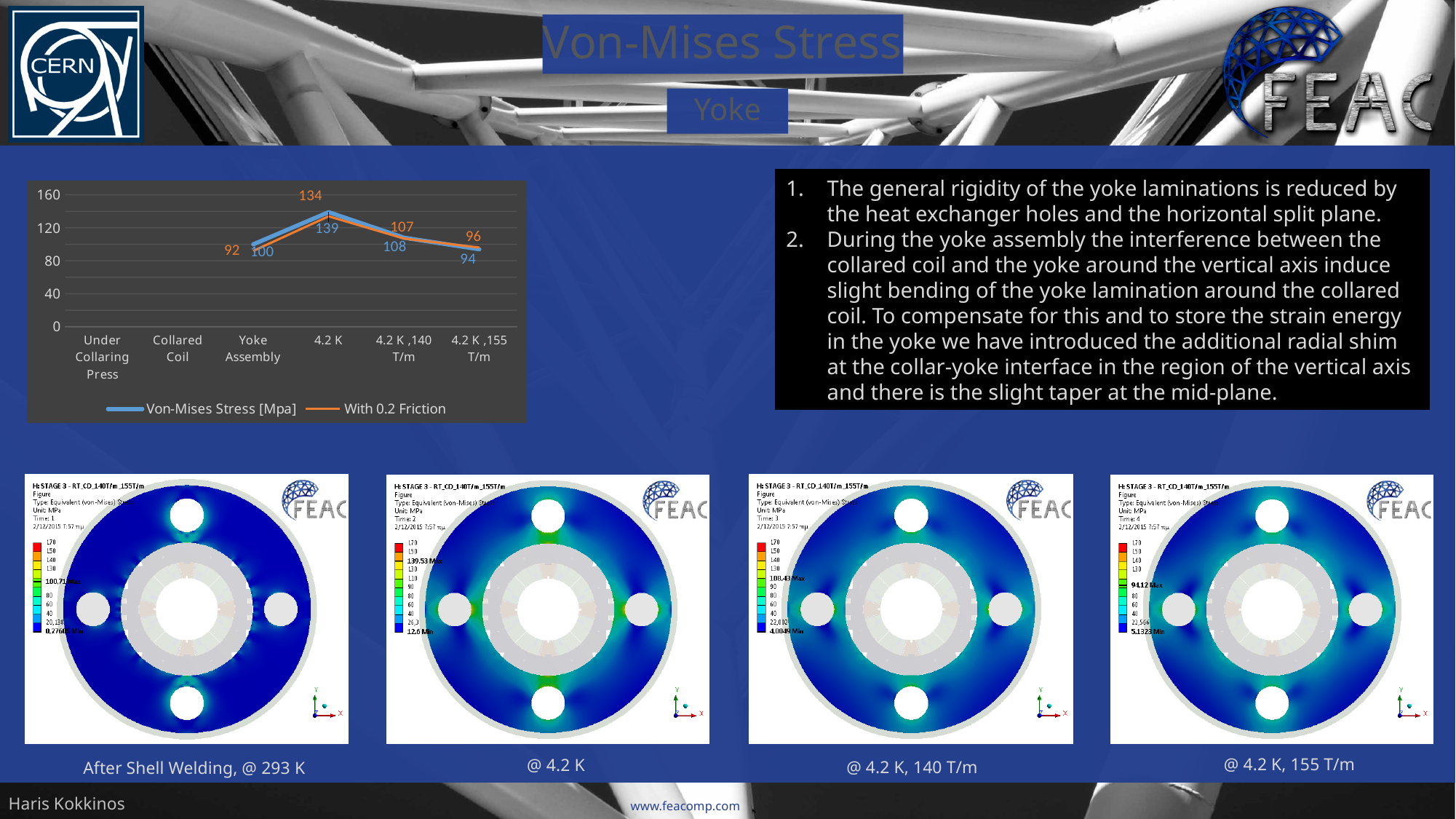
What is the difference between the Von-Mises Stress [Mpa] value and the With 0.2 Friction value at 4.2 K? 5 What is the With 0.2 Friction value at Yoke Assembly? 92 At which category does the Von-Mises Stress [Mpa] series reach its highest value? 4.2 K What is the Von-Mises Stress [Mpa] value at 4.2 K ,155 T/m? 94 At which category does the With 0.2 Friction series have its lowest value? Yoke Assembly How many series does the chart legend list? 2 Does the Von-Mises Stress [Mpa] series rise or fall from 4.2 K to 4.2 K ,155 T/m? fall How many categories are labelled on the x axis of the chart? 6 Which is larger at Yoke Assembly: the Von-Mises Stress [Mpa] value or the With 0.2 Friction value? Von-Mises Stress [Mpa] What is the With 0.2 Friction value at 4.2 K ,140 T/m? 107 What is the Von-Mises Stress [Mpa] value at 4.2 K? 139 What type of chart is shown on the slide? line chart